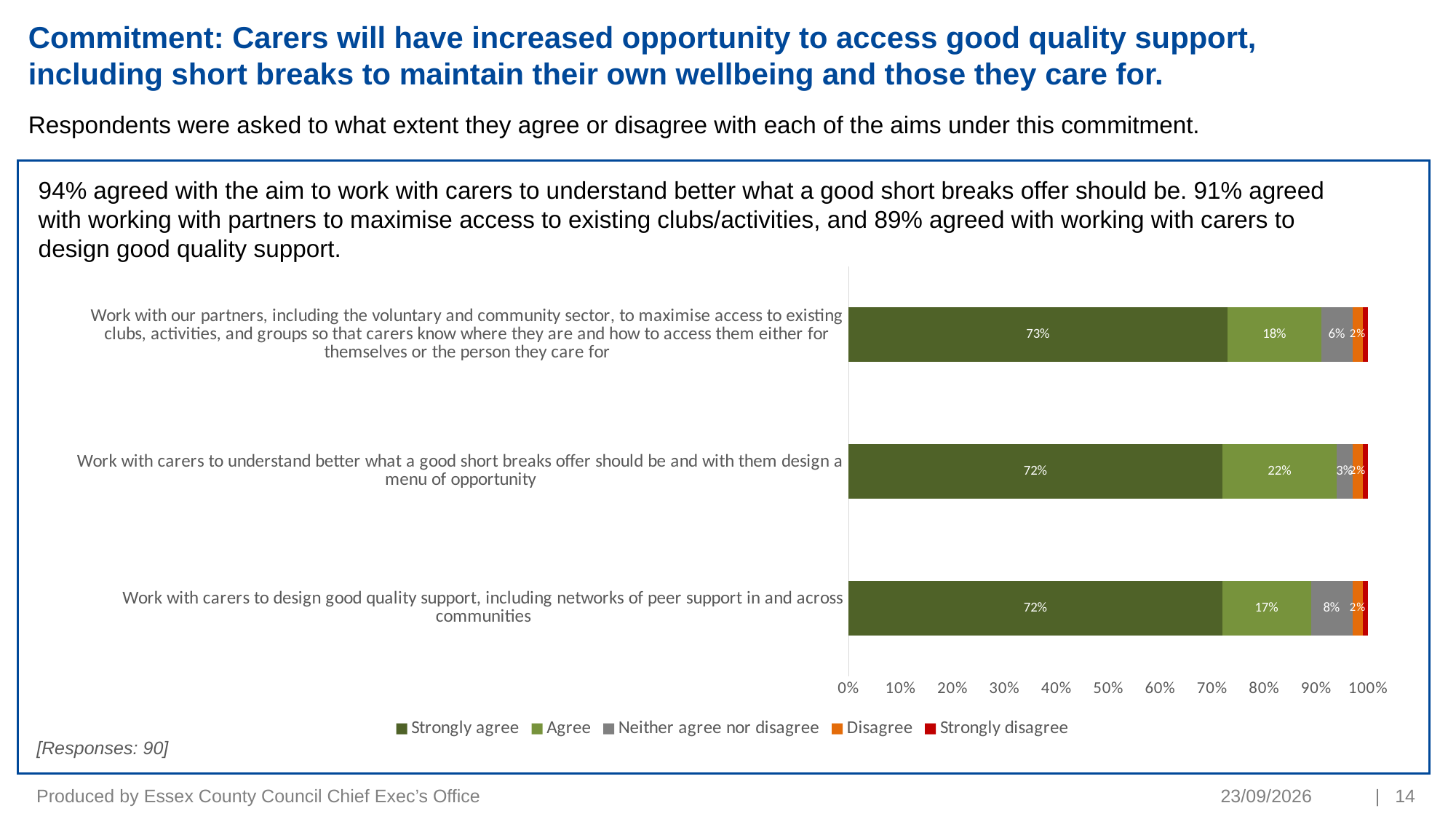
What percentage of respondents disagreed with the aim to work with partners to maximise access to existing clubs, activities, and groups? 2% What type of chart is shown on the slide? Stacked bar chart Which aim has the highest 'Agree' percentage? Work with carers to understand better what a good short breaks offer should be and with them design a menu of opportunity How many response options does the legend list? 5 What percentage of respondents strongly agreed with the aim to work with partners to maximise access to existing clubs, activities, and groups? 73% What colour represents 'Strongly agree' in the chart? Dark green Which aim has a larger 'Strongly agree' percentage: working with partners to maximise access to existing clubs, or working with carers to design good quality support? Working with partners to maximise access to existing clubs What is the difference in percentage points between the 'Agree' share for the short breaks aim and the 'Agree' share for the partners/clubs aim? 4 percentage points What percentage of respondents neither agreed nor disagreed with the aim to work with carers to design good quality support, including networks of peer support? 8% What percentage of respondents agreed (not strongly) with the aim to work with carers to understand better what a good short breaks offer should be? 22% Which aim has the lowest 'Neither agree nor disagree' percentage? Work with carers to understand better what a good short breaks offer should be and with them design a menu of opportunity How many aims (categories) are shown in the chart? 3